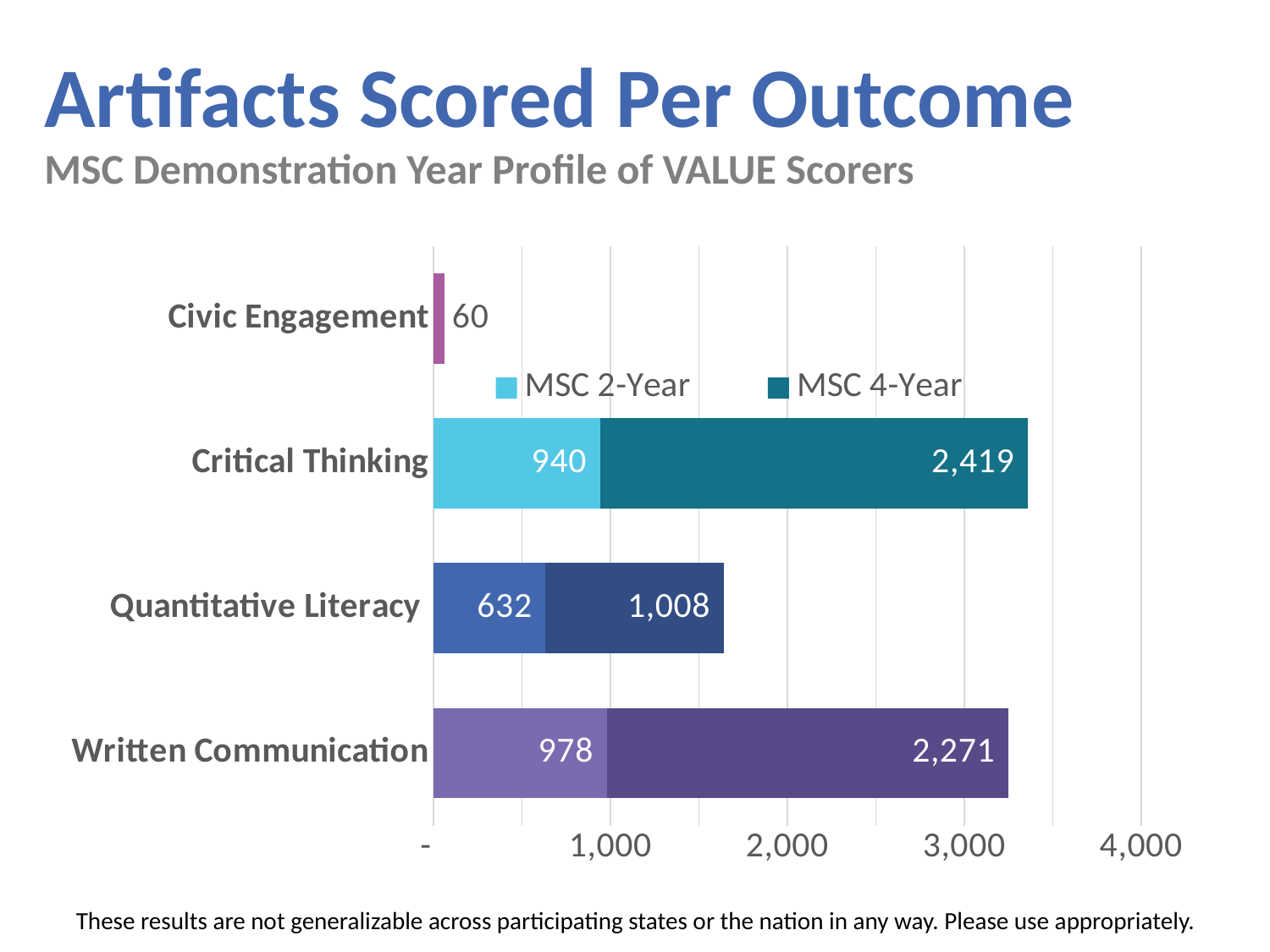
Which outcome has the highest MSC 4-Year value? Critical Thinking Which is larger: the MSC 2-Year value for Written Communication or the MSC 2-Year value for Critical Thinking? Written Communication What is the MSC 4-Year value for Written Communication? 2,271 Which outcome has the lowest total number of artifacts scored? Civic Engagement What is the MSC 2-Year value for Quantitative Literacy? 632 What value is shown for Civic Engagement? 60 What is the MSC 4-Year value for Critical Thinking? 2,419 What kind of chart is shown on the slide? Stacked bar chart How many series does the legend list? 2 How many outcome categories are shown on the chart? 4 What is the difference between the MSC 4-Year and MSC 2-Year values for Quantitative Literacy? 376 What is the total of the stacked bar for Critical Thinking? 3,359